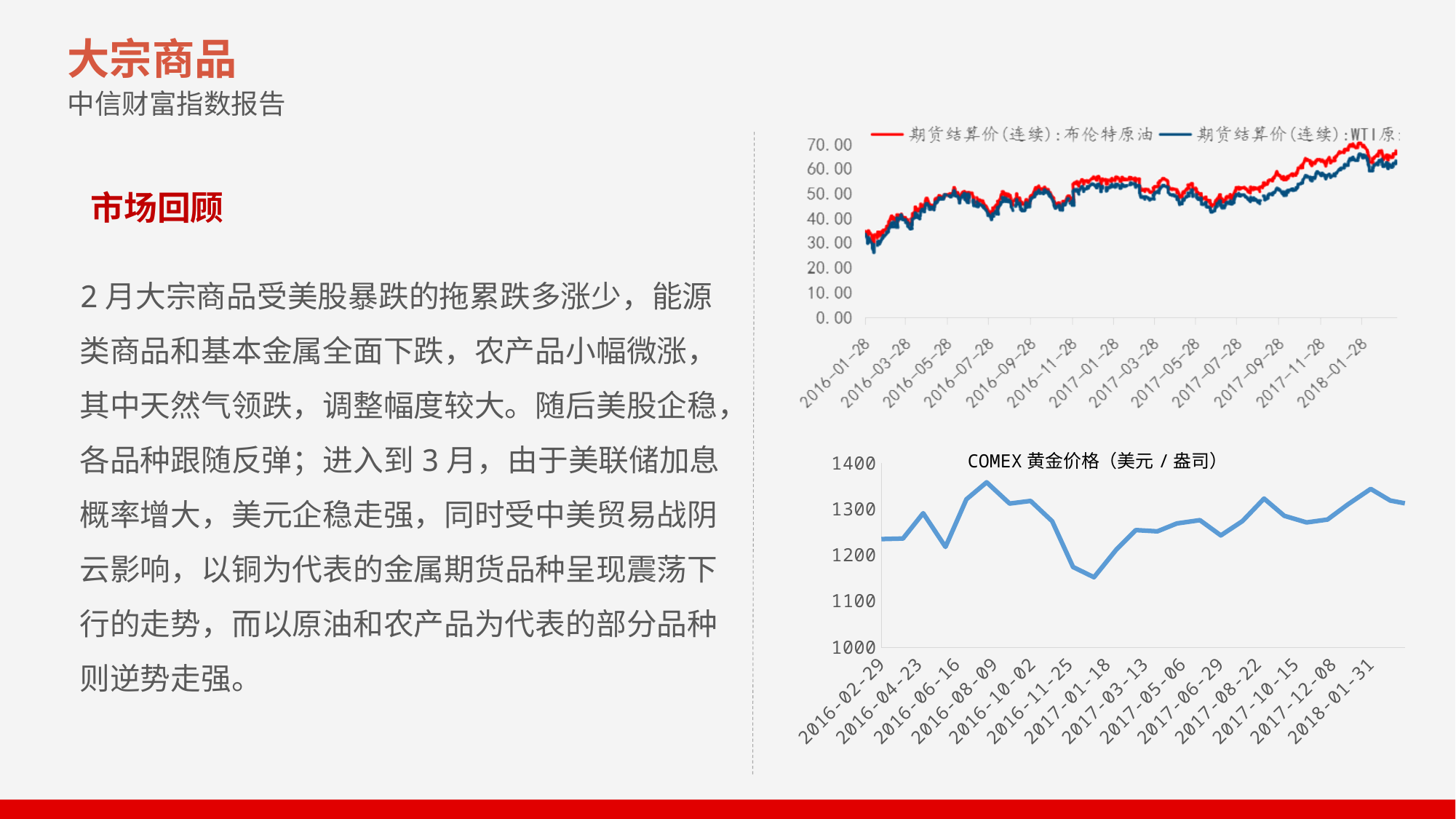
How many series does the legend of the top chart list? 2 In the top chart, is the value of the red series (布伦特原油) at 2018-01-28 greater or less than 60.00? greater In the top chart, at 2018-01-28, which series is higher: 布伦特原油 or WTI原油? 布伦特原油 What kind of chart is the bottom chart (COMEX 黄金价格)? line chart In the top chart, which series is drawn in red? 期货结算价(连续):布伦特原油 What is the title of the bottom chart? COMEX 黄金价格（美元／盎司） In the top chart, do the values generally rise or fall from 2016-01-28 to 2018-01-28? rise In the bottom chart (COMEX 黄金价格), is the value at 2016-02-29 greater or less than 1300? less In the bottom chart (COMEX 黄金价格), is the value at 2017-01-18 greater or less than 1200? less In the bottom chart (COMEX 黄金价格), do the values rise or fall from 2016-08-09 to 2017-01-18? fall What kind of chart is the top chart on the slide? line chart